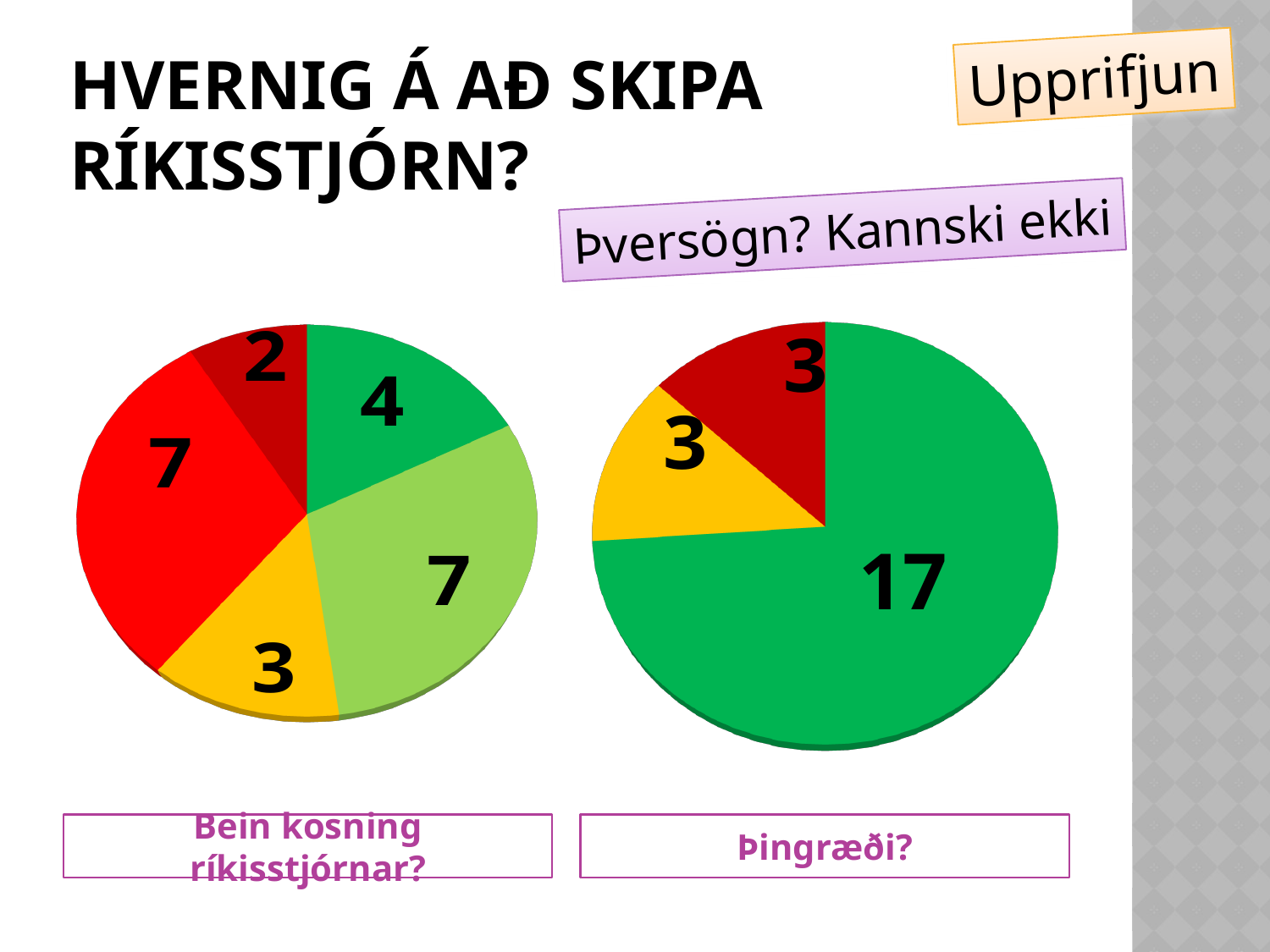
What is the label shown under the right pie chart? Þingræði? In the right pie chart ("Þingræði?"), what is the value of the largest slice? 17 In the left pie chart ("Bein kosning ríkisstjórnar?"), what is the value of the dark red slice? 2 In the left pie chart ("Bein kosning ríkisstjórnar?"), what is the value of the smallest slice? 2 What is the total of all slice values in the right pie chart ("Þingræði?")? 23 In the right pie chart ("Þingræði?"), what is the difference between the green slice and the yellow slice? 14 How many slices does the right pie chart ("Þingræði?") have? 3 In the left pie chart ("Bein kosning ríkisstjórnar?"), what is the value of the yellow slice? 3 In the right pie chart ("Þingræði?"), what is the value of the yellow slice? 3 What kind of chart is the left chart, labelled "Bein kosning ríkisstjórnar?"? pie chart In the left pie chart ("Bein kosning ríkisstjórnar?"), which is larger: the bright red slice or the dark green slice? the bright red slice How many slices does the left pie chart ("Bein kosning ríkisstjórnar?") have? 5